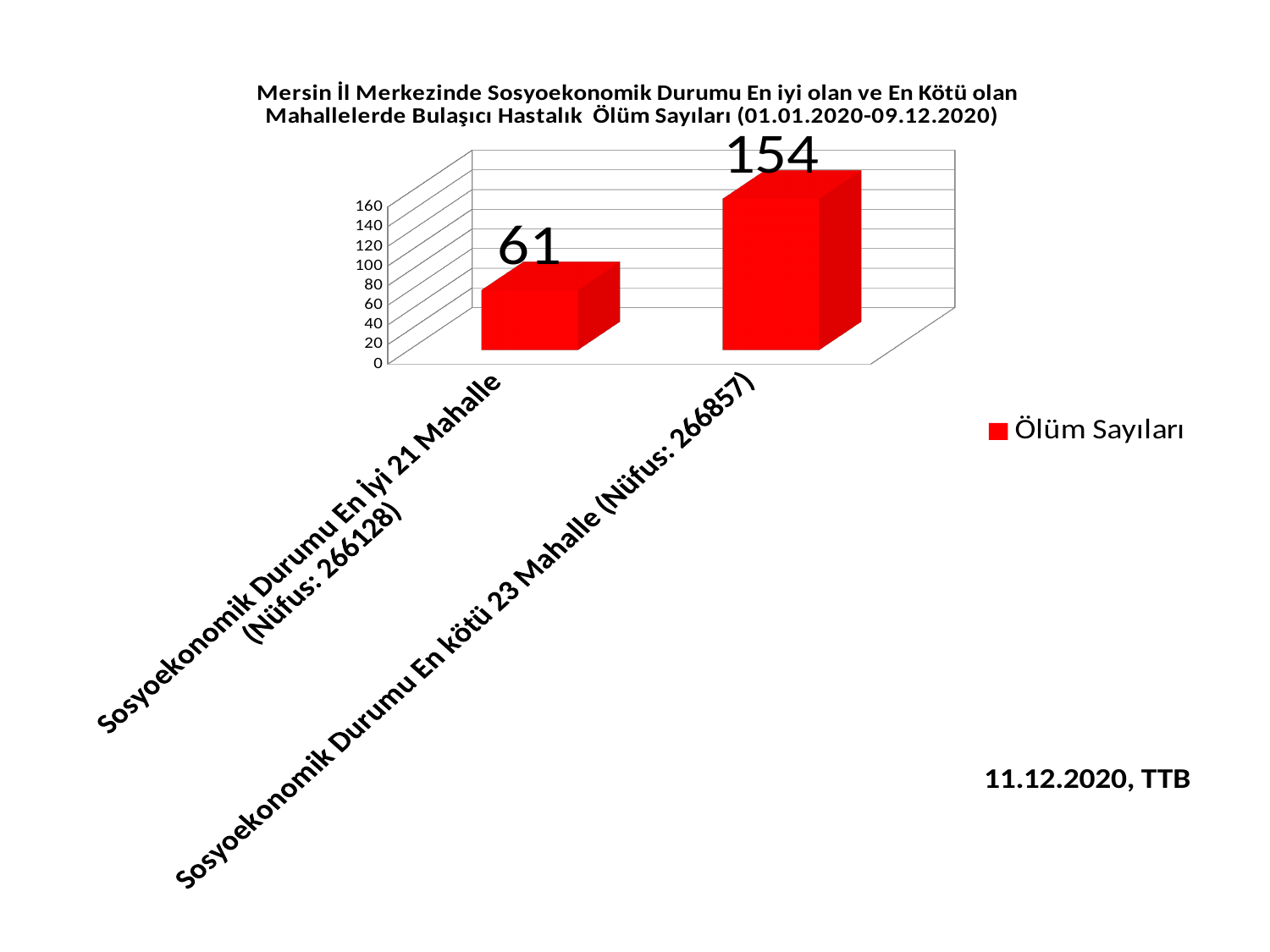
How many categories are shown on the chart? 2 Is the value for 'Sosyoekonomik Durumu En İyi 21 Mahalle' greater or less than 80? less What is the name of the series shown in the legend? Ölüm Sayıları Which is larger: the value for 'En İyi 21 Mahalle' or the value for 'En kötü 23 Mahalle'? En kötü 23 Mahalle What is the value for 'Sosyoekonomik Durumu En İyi 21 Mahalle (Nüfus: 266128)'? 61 What is the difference between the values for the 'En kötü 23 Mahalle' and the 'En İyi 21 Mahalle' categories? 93 What kind of chart is shown on the slide? Bar chart Is the value for 'Sosyoekonomik Durumu En kötü 23 Mahalle' greater or less than 140? greater Which category has the lowest value? Sosyoekonomik Durumu En İyi 21 Mahalle (Nüfus: 266128) What is the value for 'Sosyoekonomik Durumu En kötü 23 Mahalle (Nüfus: 266857)'? 154 How many series does the legend list? 1 Which category has the highest value? Sosyoekonomik Durumu En kötü 23 Mahalle (Nüfus: 266857)